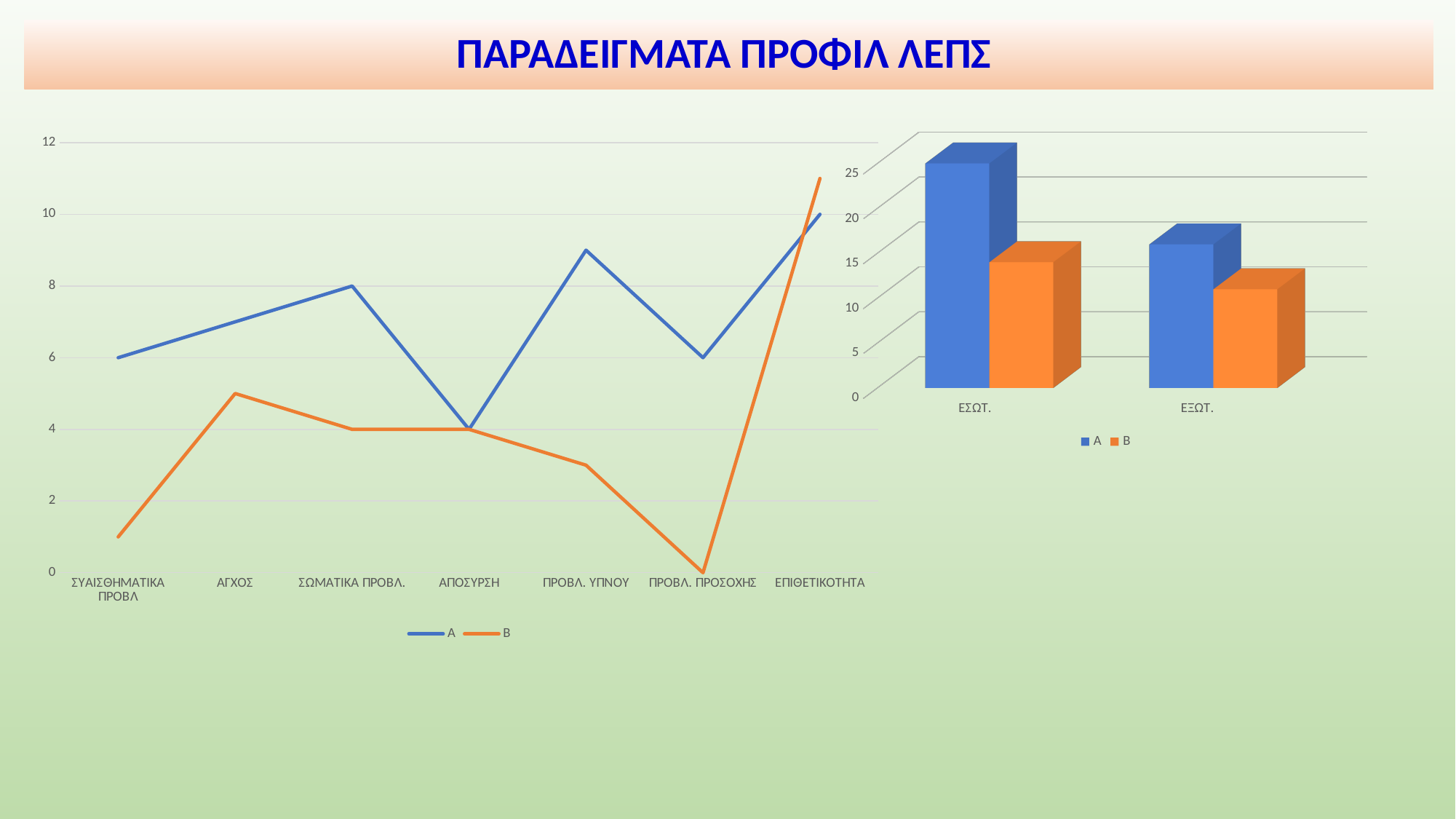
On the line chart on the left, which series has the larger value at ΠΡΟΒΛ. ΥΠΝΟΥ, A or B? A On the line chart on the left, which category has the highest value for series B? ΕΠΙΘΕΤΙΚΟΤΗΤΑ On the line chart on the left, what is the value of series B for ΑΠΟΣΥΡΣΗ? 4 On the line chart on the left, which category has the lowest value for series B? ΠΡΟΒΛ. ΠΡΟΣΟΧΗΣ On the bar chart on the right, is the value of series B for ΕΞΩΤ. greater or less than 15? less What type of chart is shown on the right side of the slide? bar chart On the line chart on the left, what is the value of series A for ΕΠΙΘΕΤΙΚΟΤΗΤΑ? 10 On the line chart on the left, how many categories are shown on the x axis? 7 On the line chart on the left, what is the difference between series A and series B at ΣΩΜΑΤΙΚΑ ΠΡΟΒΛ.? 4 On the bar chart on the right, is the value of series A for ΕΣΩΤ. greater or less than 20? greater On the line chart on the left, what is the value of series B for ΠΡΟΒΛ. ΠΡΟΣΟΧΗΣ? 0 On the line chart on the left, what is the value of series A for ΣΩΜΑΤΙΚΑ ΠΡΟΒΛ.? 8